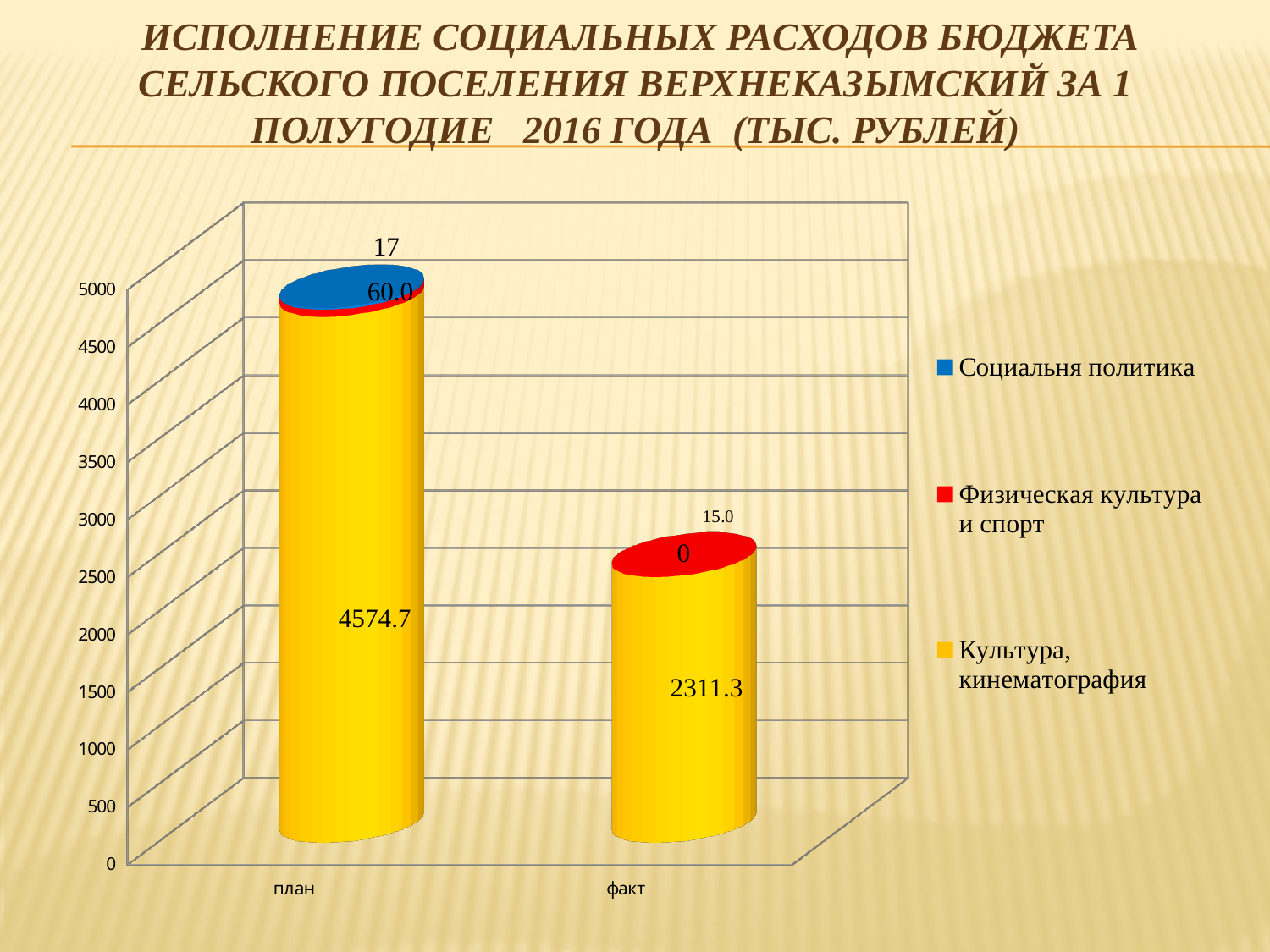
What kind of chart is shown on the slide? stacked bar chart Is the value of Культура, кинематография for план greater or less than 4500? greater What is the total of the stacked bar for факт? 2326.3 How many series does the legend list? 3 What is the value of Культура, кинематография for план? 4574.7 What is the total of the stacked bar for план? 4651.7 What is the value of Культура, кинематография for факт? 2311.3 How many categories are shown on the x axis? 2 Which colour represents Физическая культура и спорт in the legend? red What is the difference between the план and факт values for Культура, кинематография? 2263.4 Is the value of Культура, кинематография for факт greater or less than 2000? greater Which category has the higher value for Культура, кинематография, план or факт? план